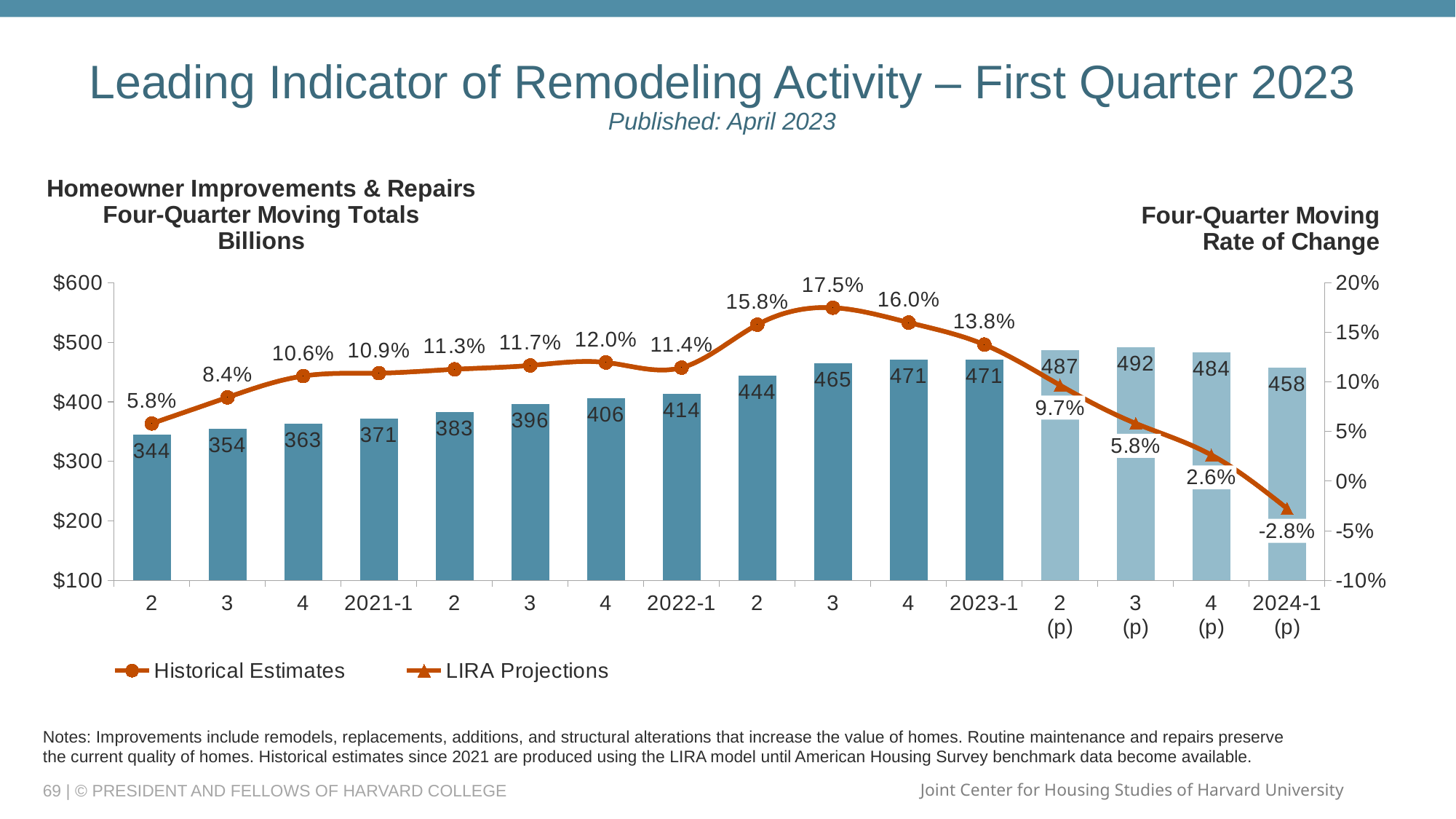
What is the projected four-quarter moving total for 2024-1 (p)? 458 How many series does the legend list? 2 How many bars are plotted on the chart? 16 Does the rate of change line rise or fall from 2023-1 to 2024-1 (p)? fall What is the difference between the four-quarter moving totals for 2023-1 and 2024-1 (p)? 13 Which bar has the highest four-quarter moving total? 3 (p) What is the lowest four-quarter moving total shown among the bars? 344 What is the lowest rate of change shown on the line? -2.8% What four-quarter moving rate of change is shown for 2023-1? 13.8% What is the four-quarter moving total shown for the bar labeled 2022-1? 414 What is the highest four-quarter moving rate of change shown on the line? 17.5% Which has the larger four-quarter moving total, 2021-1 or 2022-1? 2022-1